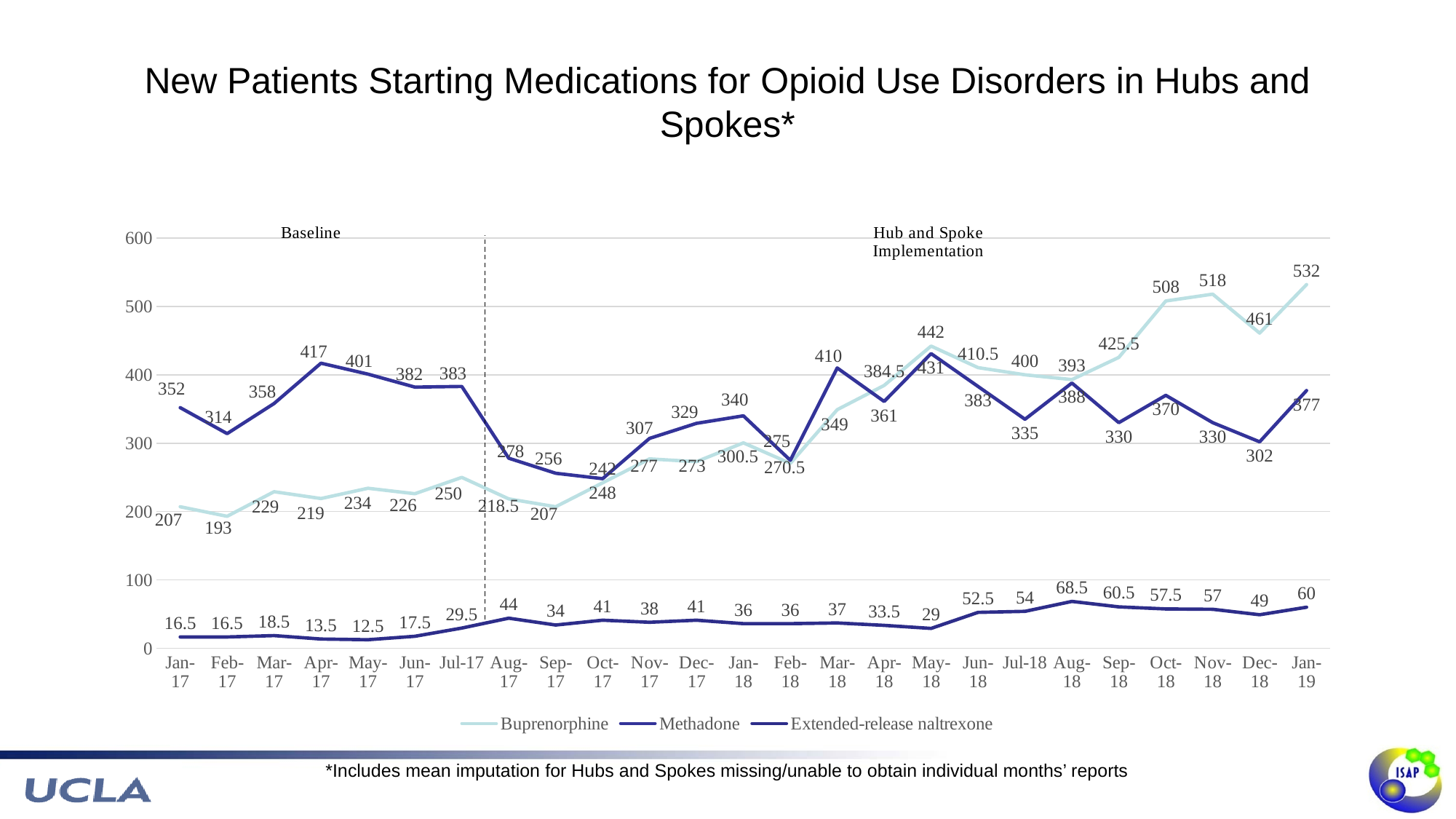
What is the difference between the Buprenorphine values for Jan-19 and Jan-17? 325 In Oct-18, which is larger: the Buprenorphine value or the Methadone value? Buprenorphine How many series does the legend list? 3 In which month is the Extended-release naltrexone value lowest? May-17 In which month is the Buprenorphine value lowest? Feb-17 How many months are plotted on the x axis? 25 What kind of chart is shown on the slide? Line chart What is the Buprenorphine value for Jan-19? 532 What is the Methadone value for Apr-17? 417 In which month is the Methadone value highest? May-18 What is the Extended-release naltrexone value for Aug-18? 68.5 In which month is the Buprenorphine value highest? Jan-19